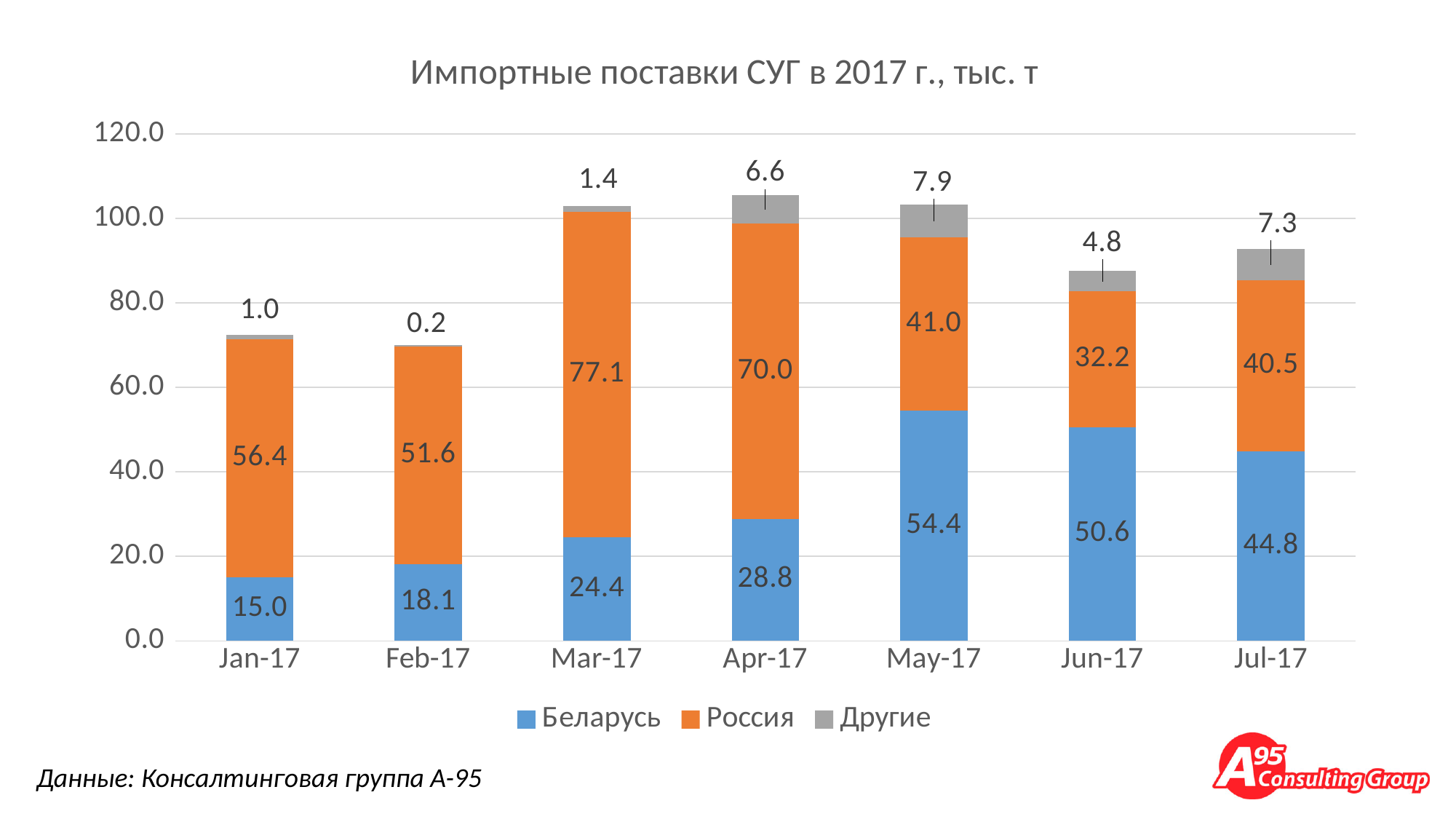
What is the value for Беларусь in May-17? 54.4 In which month is the value for Россия highest? Mar-17 In which month is the value for Беларусь lowest? Jan-17 How many months are shown on the x axis? 7 Which is larger in Jul-17: the value for Беларусь or the value for Россия? Беларусь What is the title of the chart? Импортные поставки СУГ в 2017 г., тыс. т What is the value for Россия in Mar-17? 77.1 What is the total of the stacked bar for Apr-17? 105.4 How many series does the legend list? 3 What type of chart is shown on the slide? Stacked bar chart What is the difference between the Россия values in Apr-17 and Jun-17? 37.8 What is the value for Другие in Feb-17? 0.2